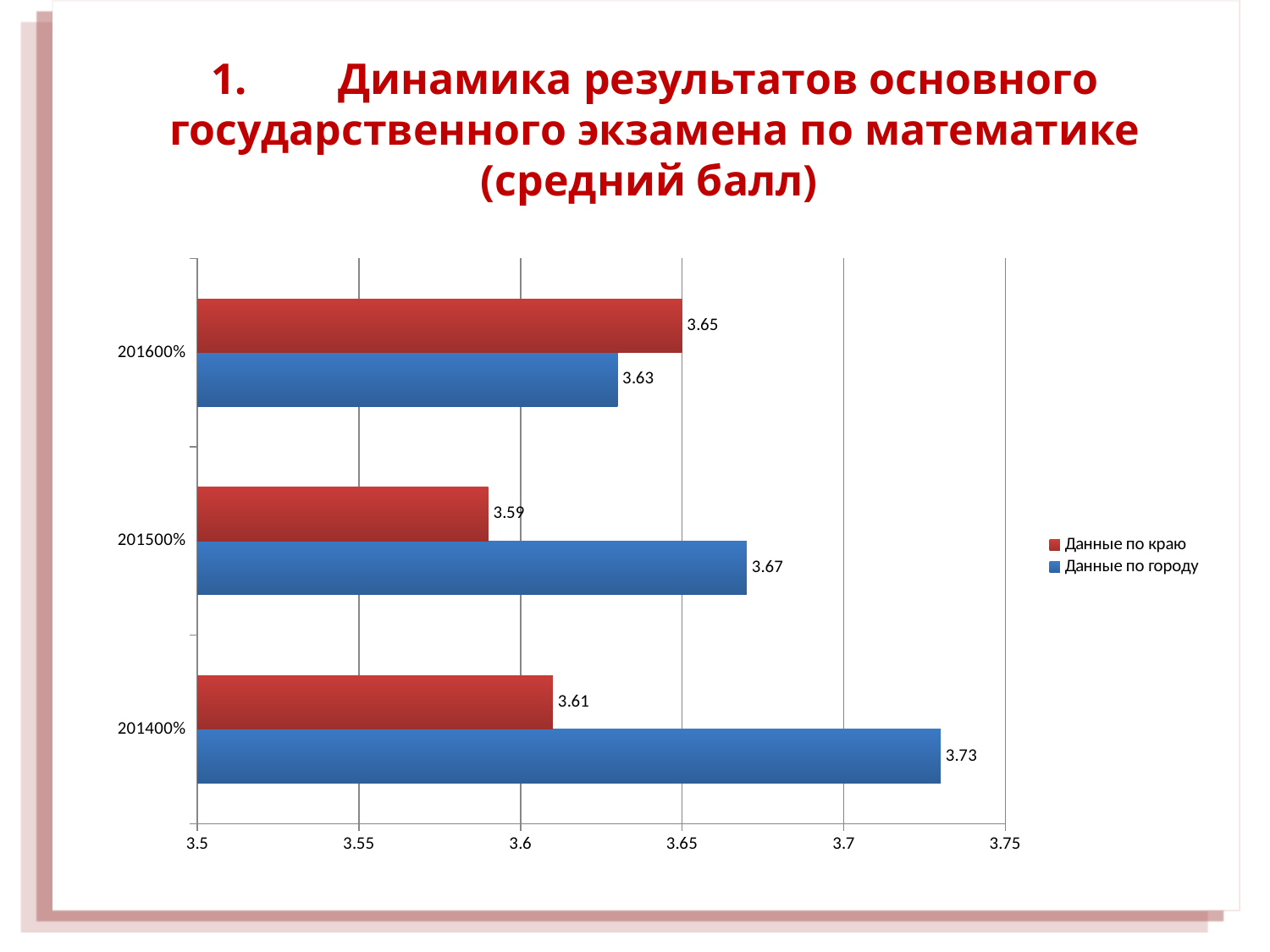
What kind of chart is shown on the slide? bar chart What is the value of "Данные по краю" for the category labelled 201500%? 3.59 How many series does the legend list? 2 What is the value of "Данные по городу" for the category labelled 201400%? 3.73 Is the value of "Данные по городу" for the category labelled 201500% greater or less than 3.65? greater What is the difference between "Данные по городу" and "Данные по краю" for the category labelled 201400%? 0.12 What is the value of "Данные по краю" for the category labelled 201600%? 3.65 For the category labelled 201600%, which series has the larger value, "Данные по краю" or "Данные по городу"? Данные по краю Which colour represents the series "Данные по городу" in the chart? blue How many categories are shown on the vertical axis of the chart? 3 Which category has the lowest value for "Данные по краю"? 201500% Which category has the highest value for "Данные по городу"? 201400%